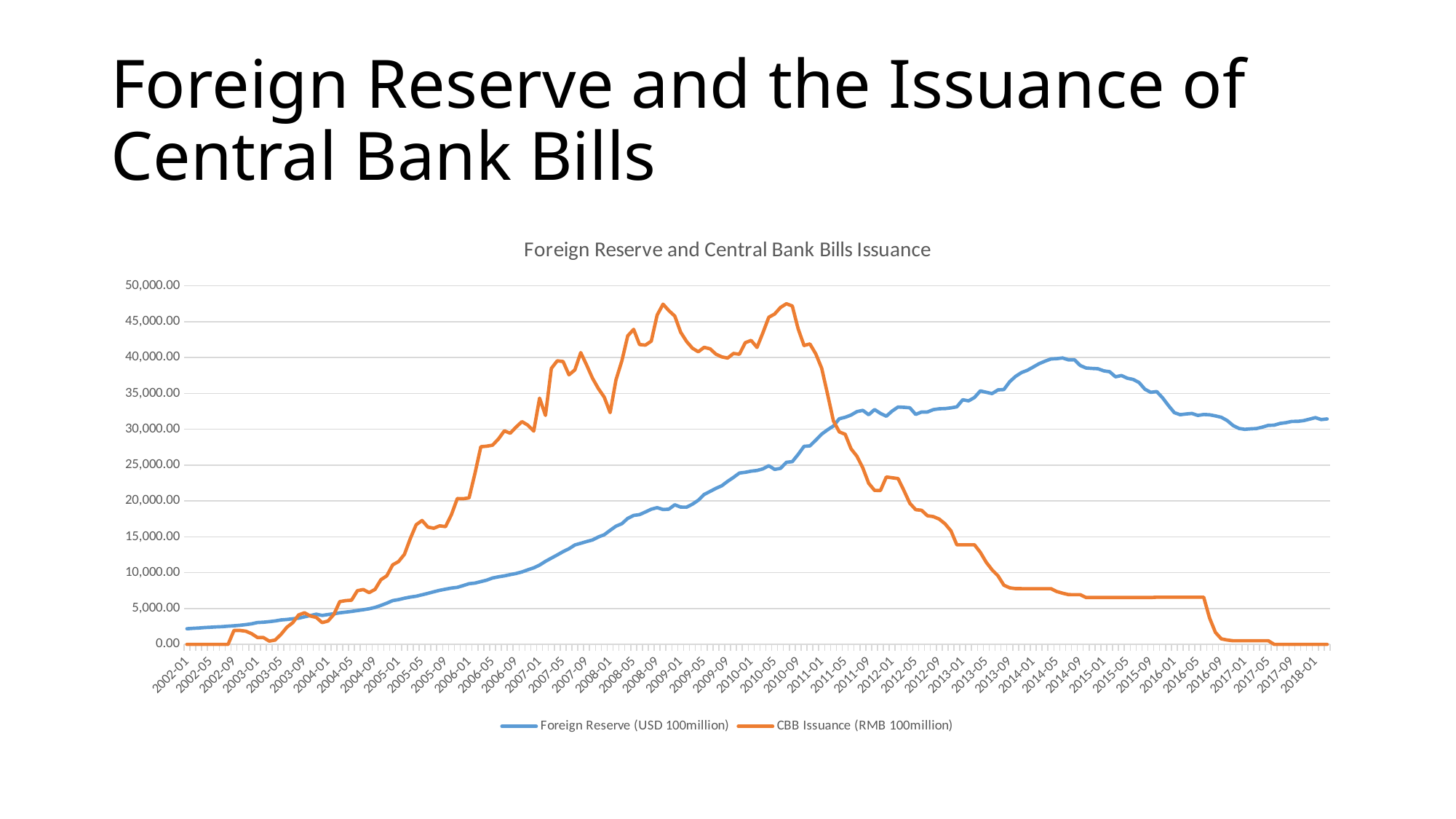
At 2008-09, which series has the larger value, Foreign Reserve (USD 100million) or CBB Issuance (RMB 100million)? CBB Issuance (RMB 100million) Does the CBB Issuance (RMB 100million) series rise or fall from 2010-09 to 2017-09? Fall At 2014-05, which series has the larger value, Foreign Reserve (USD 100million) or CBB Issuance (RMB 100million)? Foreign Reserve (USD 100million) What kind of chart is shown on the slide? Line chart Which series is drawn in orange? CBB Issuance (RMB 100million) Is the value for CBB Issuance (RMB 100million) at 2017-05 greater or less than 5,000.00? less Is the value for CBB Issuance (RMB 100million) at 2015-01 greater or less than 10,000.00? less How many series does the legend list? 2 Is the value for CBB Issuance (RMB 100million) at 2008-09 greater or less than 40,000.00? greater What is the title of the chart? Foreign Reserve and Central Bank Bills Issuance